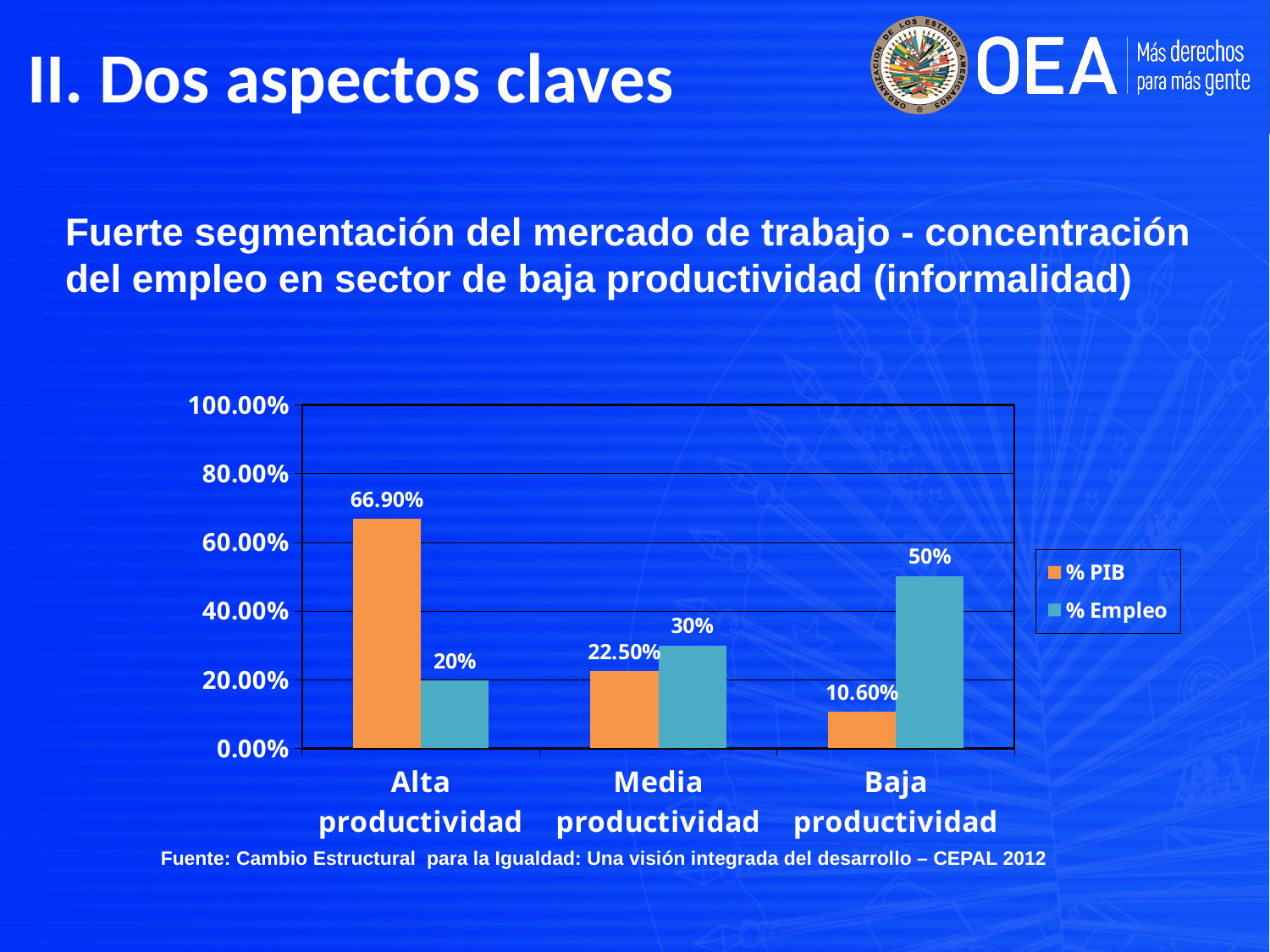
Which category has the lowest % Empleo value? Alta productividad What kind of chart is shown on the slide? Bar chart What is the % Empleo value for Baja productividad? 50% What is the % PIB value for Media productividad? 22.50% What is the % Empleo value for Alta productividad? 20% What is the difference between the % PIB and % Empleo values for Baja productividad? 39.40% What is the % PIB value for Alta productividad? 66.90% How many categories are shown on the x axis? 3 Which is larger for Media productividad, % PIB or % Empleo? % Empleo Which category has the highest % PIB value? Alta productividad Do the % PIB values rise or fall from Alta productividad to Baja productividad? Fall How many series does the legend list? 2